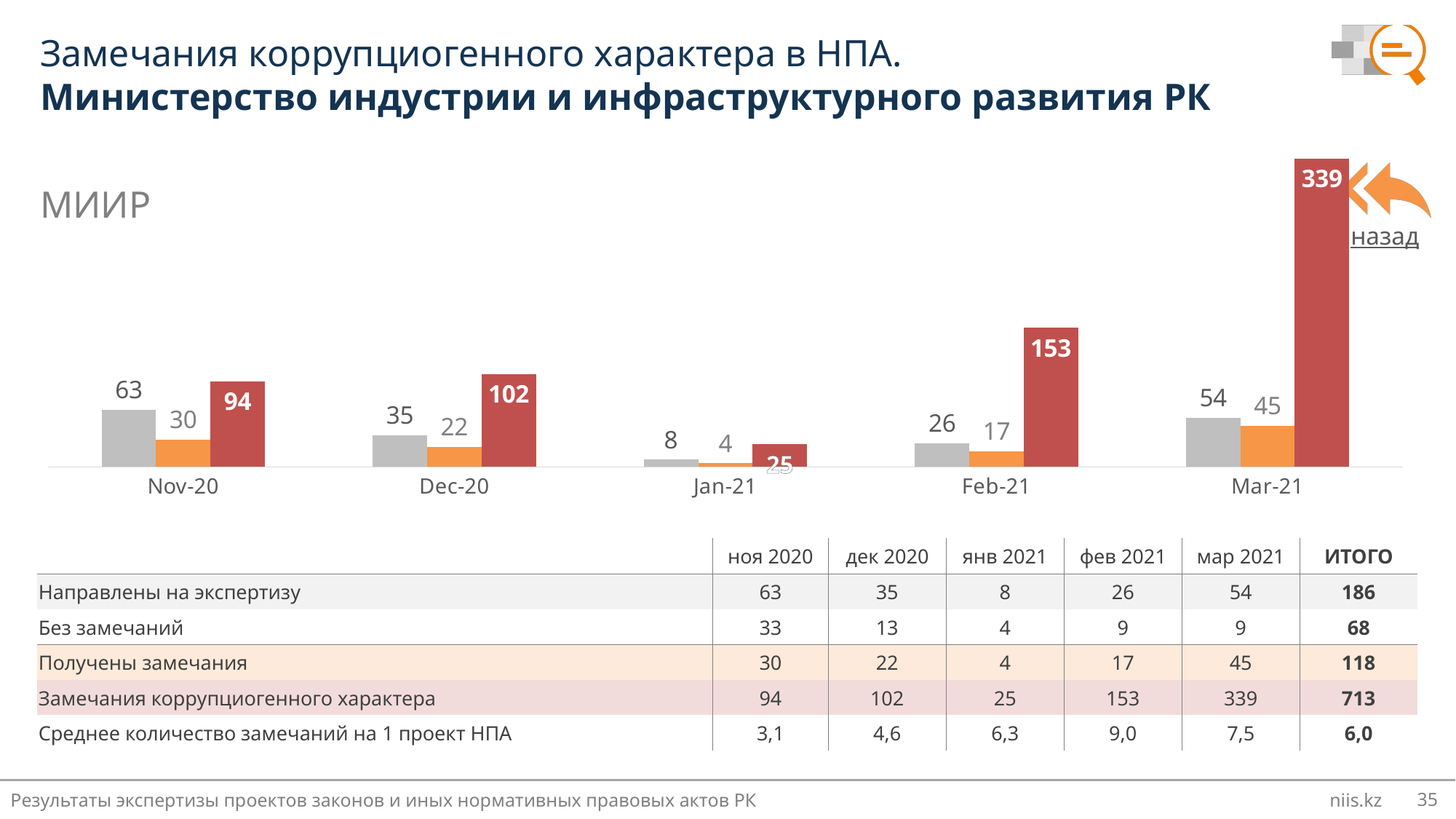
How many bars are plotted for each month in the chart? 3 What is the value of the gray bar (Направлены на экспертизу) for Nov-20? 63 In which month is the red bar (Замечания коррупциогенного характера) highest? Mar-21 What is the difference between the red bar values for Mar-21 and Feb-21? 186 What is the value of the orange bar (Получены замечания) for Feb-21? 17 What kind of chart is shown on the slide? bar chart What is the value of the red bar (Замечания коррупциогенного характера) for Mar-21? 339 Which is larger: the red bar for Dec-20 or the red bar for Nov-20? Dec-20 Does the red bar (Замечания коррупциогенного характера) rise or fall from Feb-21 to Mar-21? rise How many months are shown on the x axis of the chart? 5 In which month is the gray bar (Направлены на экспертизу) lowest? Jan-21 What colour is the bar representing Замечания коррупциогенного характера in the chart? red